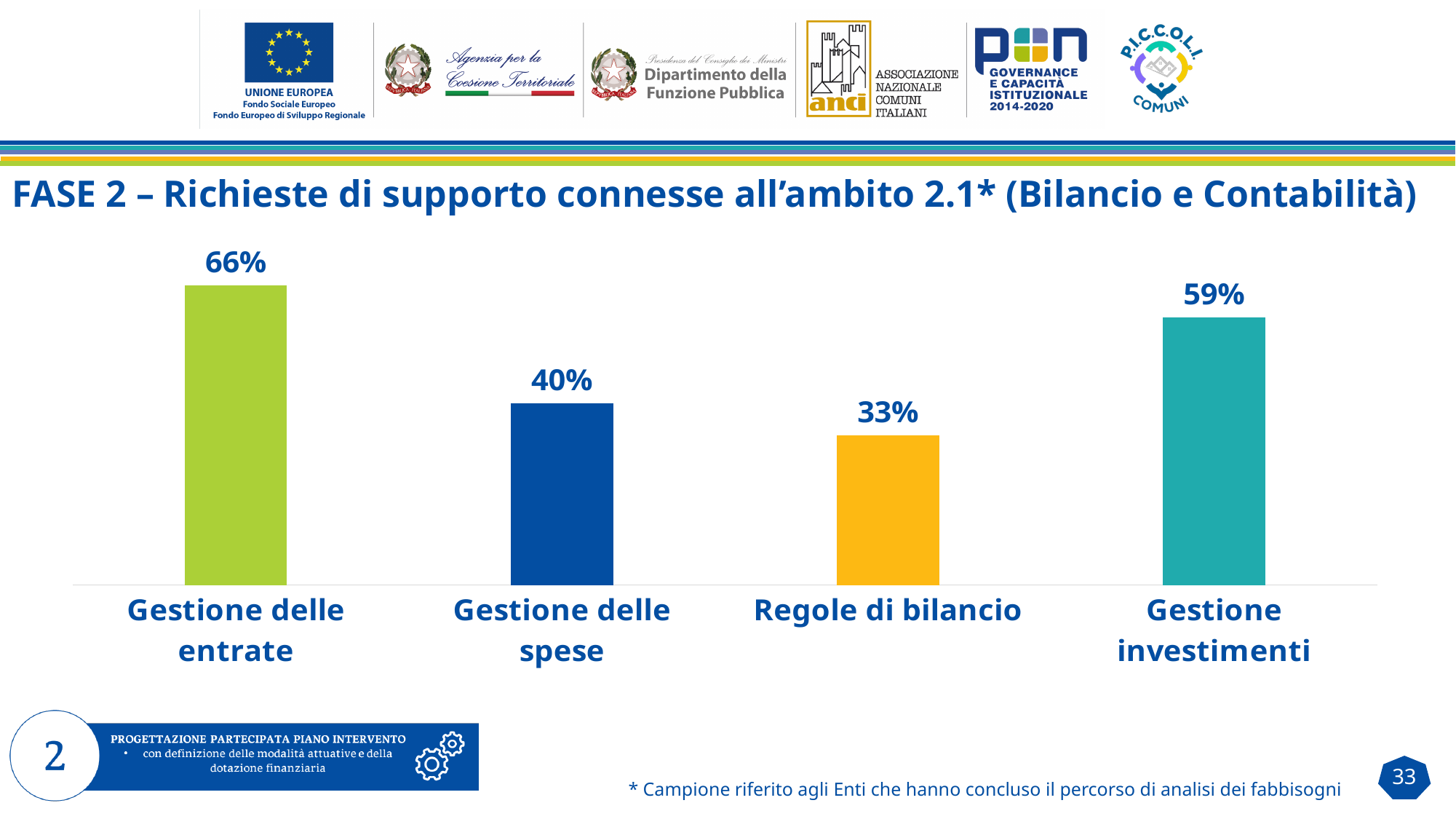
Which category has the lowest value? Regole di bilancio What kind of chart is shown on the slide? Bar chart What is the value for Gestione delle entrate? 66% What is the difference between the values for Gestione delle entrate and Gestione investimenti? 7% What is the value for Regole di bilancio? 33% How many categories are shown in the chart? 4 Which is larger, the value for Gestione delle spese or the value for Gestione investimenti? Gestione investimenti What colour is the bar for Regole di bilancio? Yellow What is the value for Gestione delle spese? 40% Which category has the highest value? Gestione delle entrate What is the value for Gestione investimenti? 59% What is the difference between the values for Gestione delle spese and Regole di bilancio? 7%